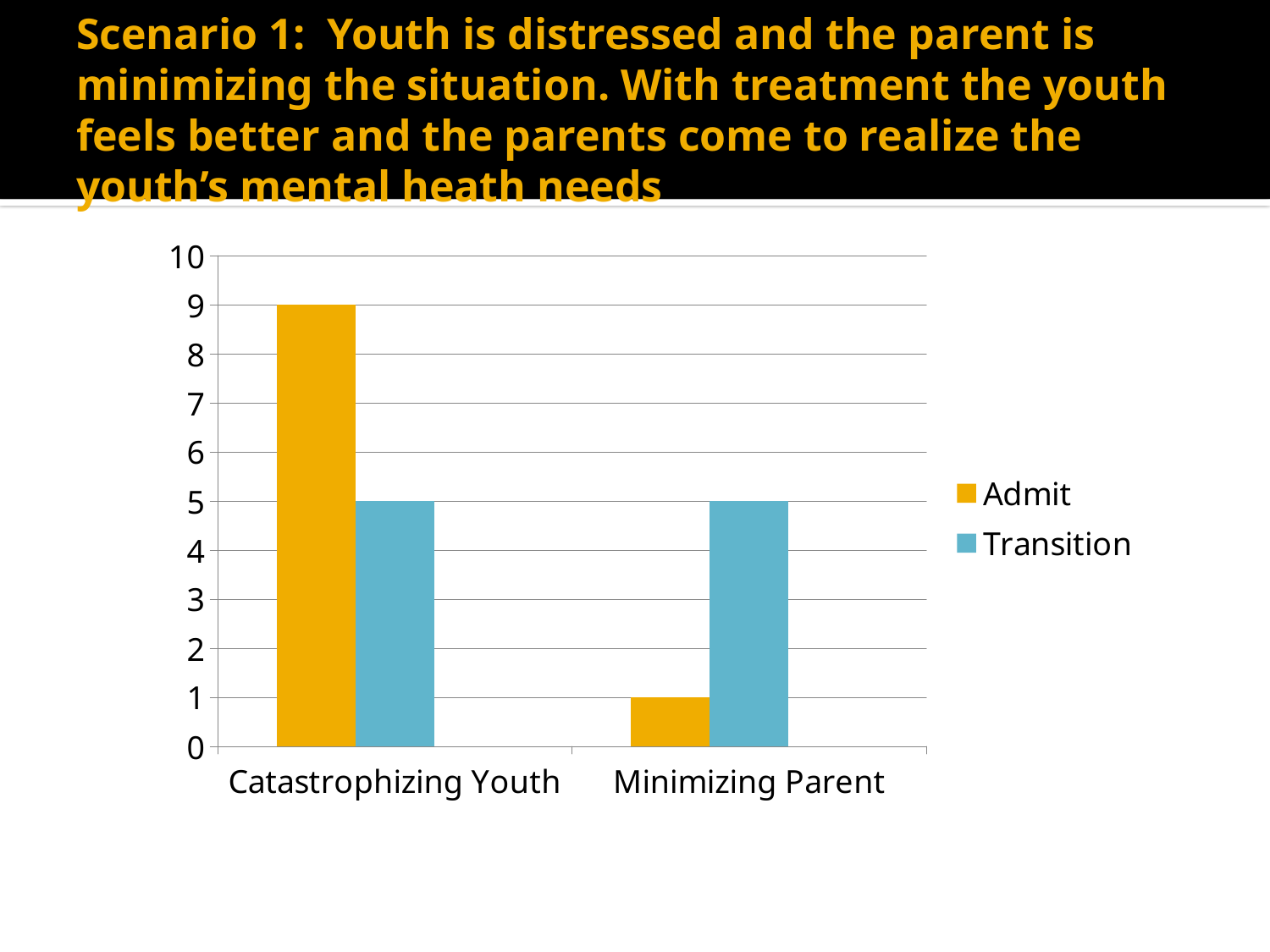
How many categories are shown on the x axis? 2 What is the Transition value for Minimizing Parent? 5 What kind of chart is shown on the slide? bar chart For Minimizing Parent, which is larger, the Admit value or the Transition value? Transition What is the Admit value for Catastrophizing Youth? 9 Which category has the lowest Admit value? Minimizing Parent Which category has the highest Admit value? Catastrophizing Youth Which series is shown in blue in the legend? Transition What is the difference between the Admit and Transition values for Catastrophizing Youth? 4 How many series does the legend list? 2 What is the Transition value for Catastrophizing Youth? 5 What is the Admit value for Minimizing Parent? 1